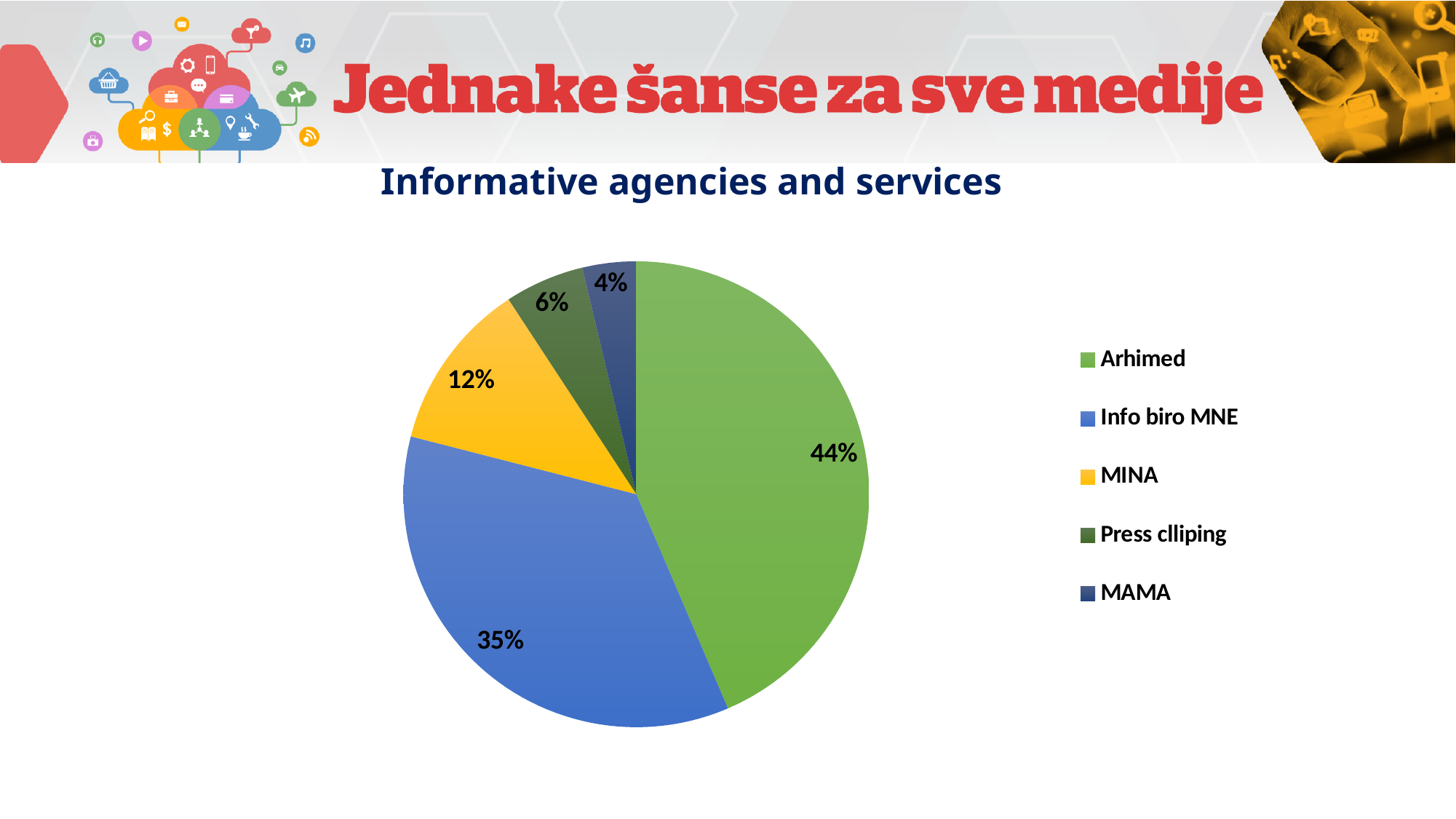
What kind of chart is shown on the slide? Pie chart Which is larger, the share for MINA or the share for Press clliping? MINA What share of the pie does MAMA hold? 4% What is the difference in percentage points between Arhimed and Info biro MNE? 9 What share of the pie does Info biro MNE hold? 35% Which category has the largest slice of the pie? Arhimed What is the title of the chart? Informative agencies and services What share of the pie does Press clliping hold? 6% What share of the pie does MINA hold? 12% How many categories does the pie chart show? 5 Which category has the smallest slice of the pie? MAMA What share of the pie does Arhimed hold? 44%